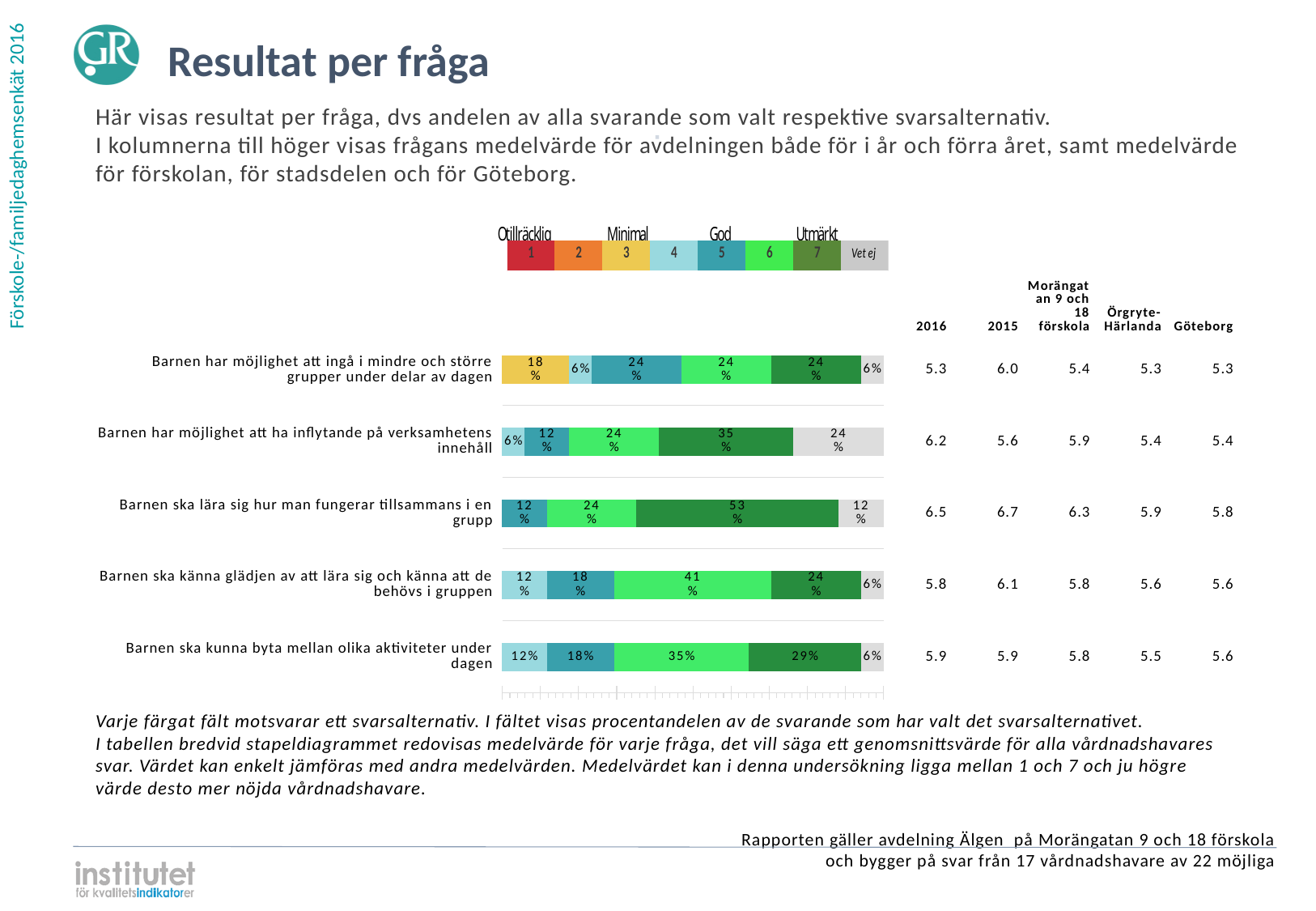
What percentage of respondents chose option 6 for 'Barnen ska känna glädjen av att lära sig och känna att de behövs i gruppen'? 41% What percentage of respondents answered 'Vet ej' for 'Barnen har möjlighet att ha inflytande på verksamhetens innehåll'? 24% What is the 2016 mean value shown for 'Barnen ska lära sig hur man fungerar tillsammans i en grupp'? 6.5 What percentage of respondents chose 'Utmärkt' (7) for 'Barnen ska lära sig hur man fungerar tillsammans i en grupp'? 53% For 'Barnen ska kunna byta mellan olika aktiviteter under dagen', what is the difference between the share choosing option 6 and the share choosing option 7? 6% For 'Barnen har möjlighet att ha inflytande på verksamhetens innehåll', which is larger: the share choosing option 7 or the share choosing option 6? Option 7 Which question has the largest single segment in its bar? Barnen ska lära sig hur man fungerar tillsammans i en grupp What are the four named rating labels shown in the legend above the chart? Otillräcklig, Minimal, God, Utmärkt How many questions (categories) are shown as bars in the chart? 5 What kind of chart is used to show the results per question on this slide? Stacked bar chart How many response options does the legend above the chart list, including 'Vet ej'? 8 What percentage of respondents chose option 3 (Minimal) for 'Barnen har möjlighet att ingå i mindre och större grupper under delar av dagen'? 18%